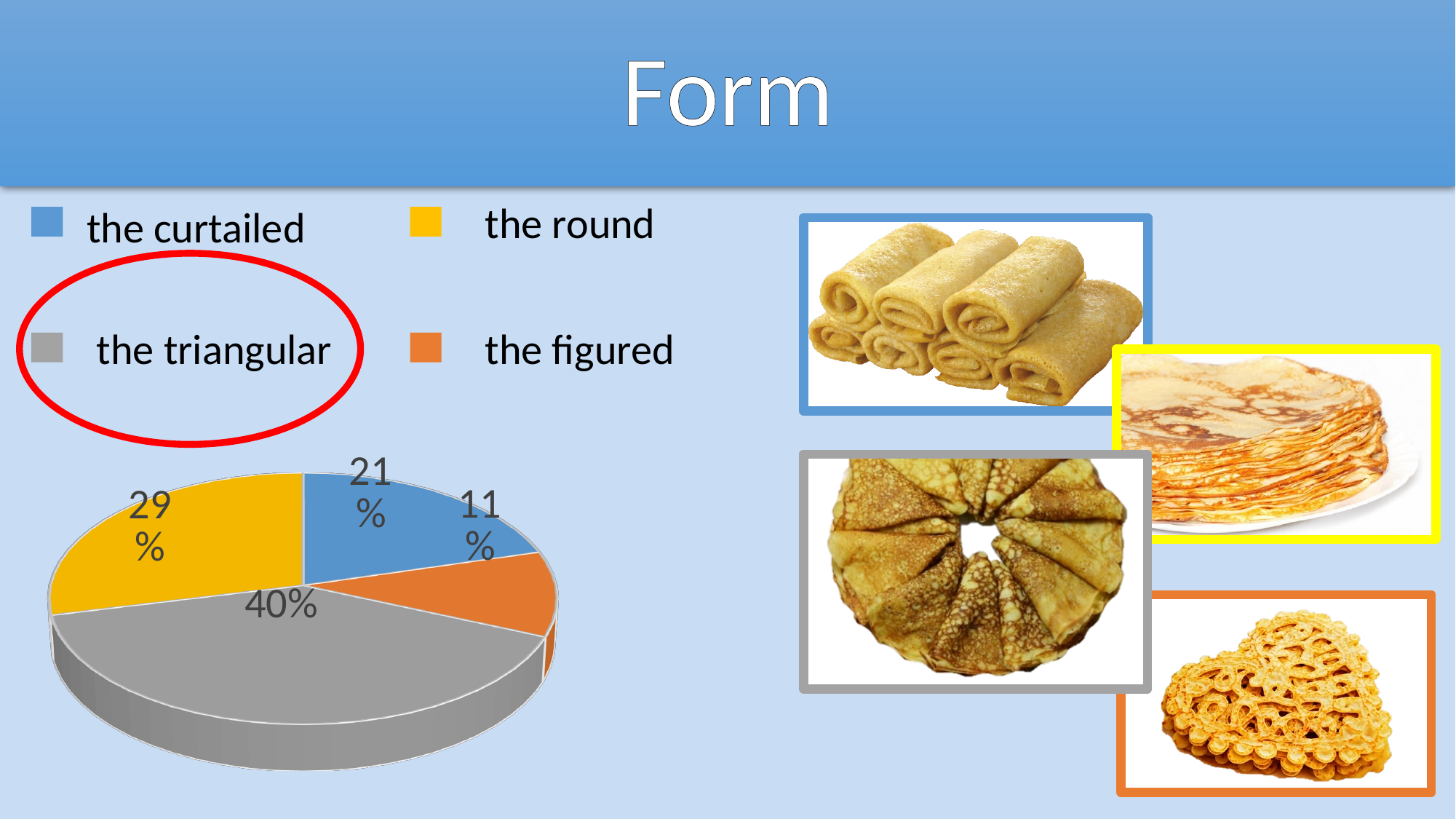
How many slices does the pie chart have? 4 What kind of chart is shown on the slide? pie chart Which form has the smallest share in the pie chart? the figured Which colour represents the figured in the pie chart? orange Which form has the largest share in the pie chart? the triangular What is the difference in percentage points between the triangular and the round? 11 Which has a larger share, the curtailed or the round? the round What percentage does the pie chart show for the curtailed? 21% Which legend entry is circled in red on the slide? the triangular What percentage does the pie chart show for the figured? 11% What percentage does the pie chart show for the triangular? 40% What percentage does the pie chart show for the round? 29%